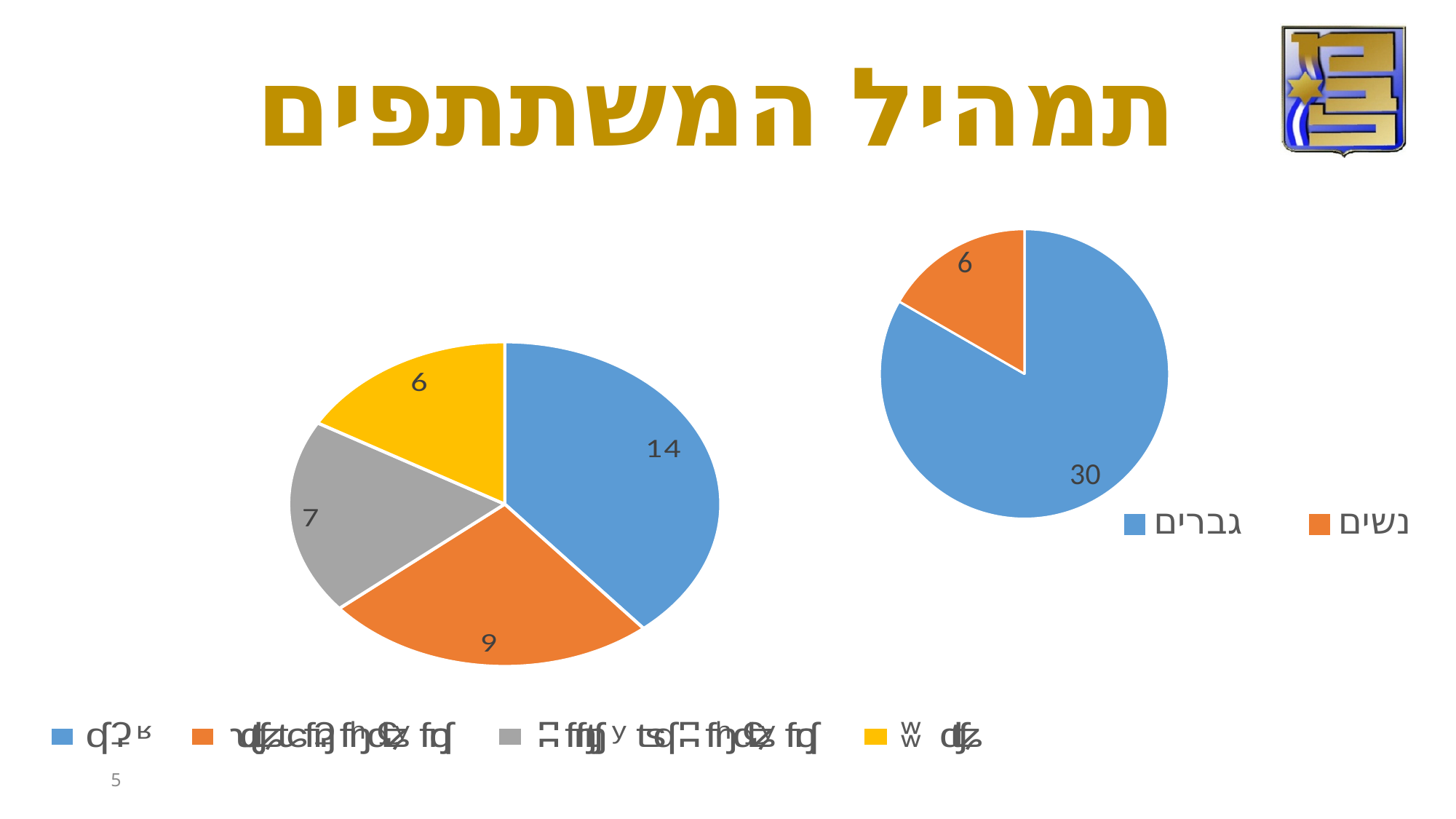
How many slices does the pie chart on the left have? 4 In the pie chart on the left, what is the value of the largest slice? 14 What is the total of all slices in the pie chart on the left? 36 In the pie chart on the right, which category is larger, גברים or נשים? גברים In the pie chart on the right, what is the value for נשים? 6 In the pie chart on the left, what is the value of the orange slice? 9 In the pie chart on the right, what is the value for גברים? 30 How many entries does the legend of the pie chart on the right list? 2 What kind of chart is the chart on the right of the slide? Pie chart In the pie chart on the left, what is the value of the smallest slice? 6 In the pie chart on the right, what is the difference between the values for גברים and נשים? 24 In the pie chart on the left, what is the difference between the largest and smallest slice values? 8